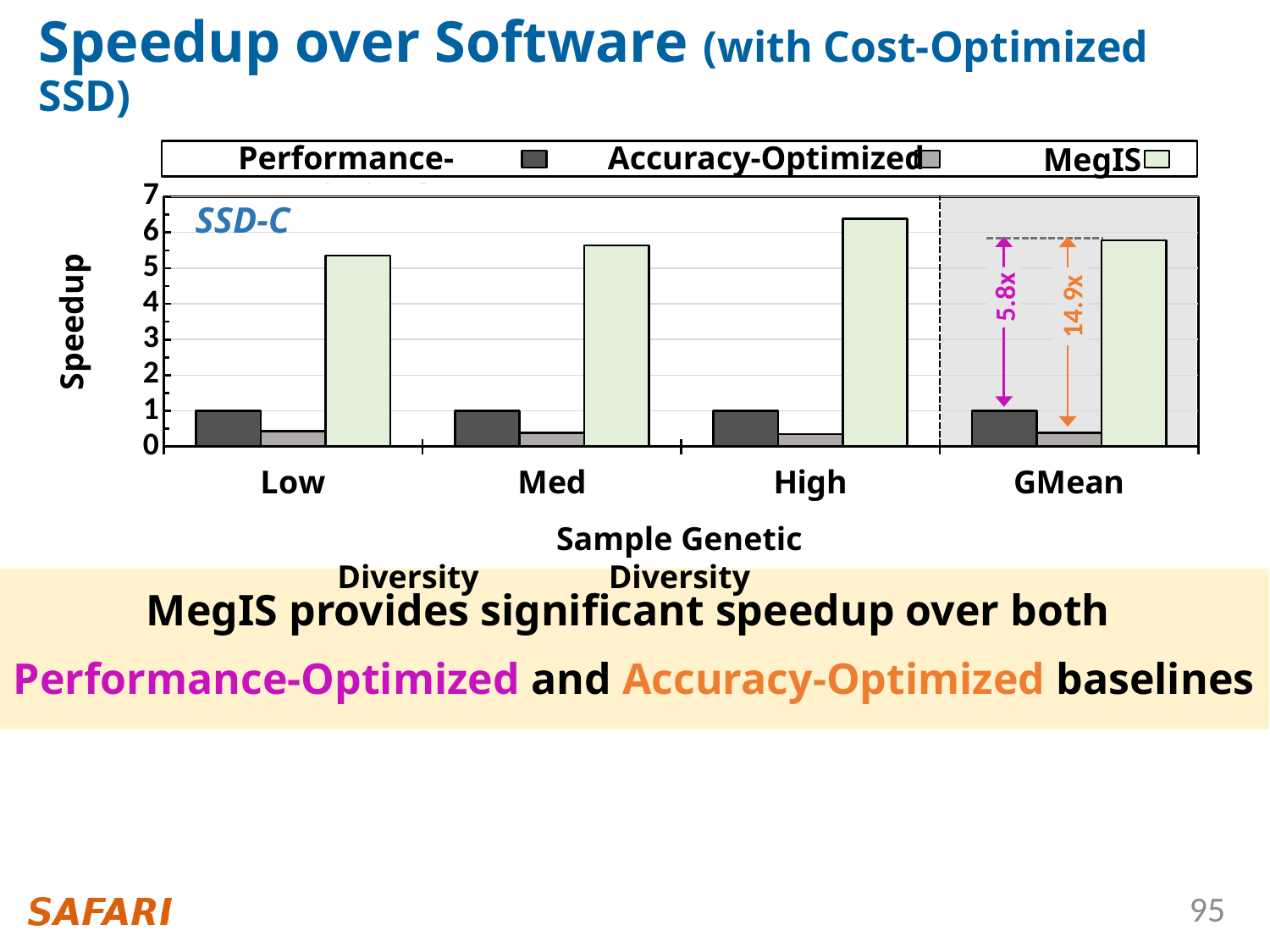
Is the MegIS value for Low greater or less than 5? greater Is the Accuracy-Optimized value for Low greater or less than 1? less How many series does the legend list? 3 Is the MegIS value for High greater or less than 6? greater What kind of chart is shown on the slide? bar chart What speedup of MegIS over the Performance-Optimized baseline is annotated at GMean? 5.8x How many categories are shown on the x axis? 4 What label is printed in the top-left corner of the plot area? SSD-C Which is larger, the MegIS value for High or the MegIS value for Low? High What is the y-axis title of the chart? Speedup What speedup of MegIS over the Accuracy-Optimized baseline is annotated at GMean? 14.9x For which category is the MegIS bar the highest? High